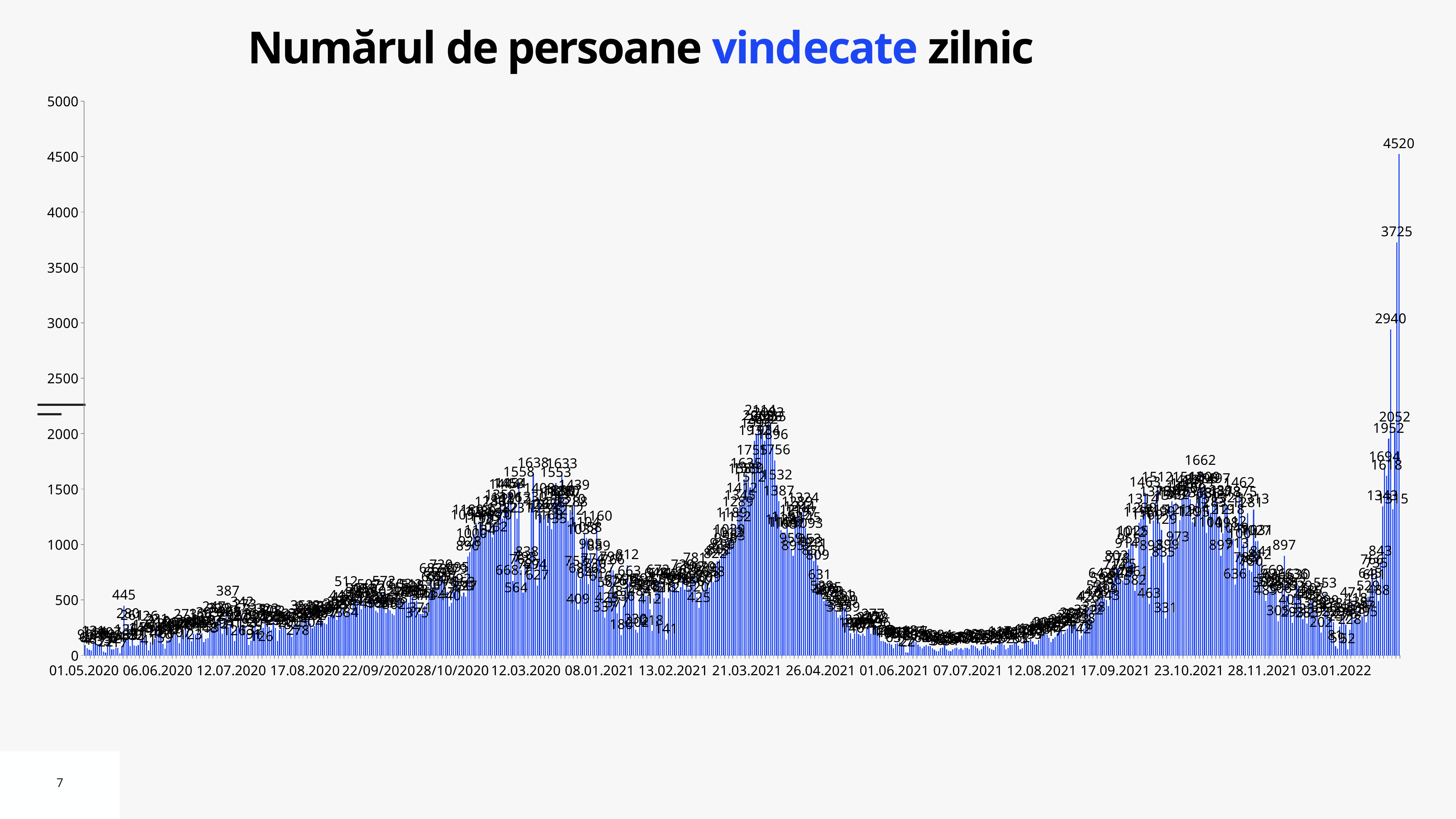
What kind of chart is shown on the slide? bar chart Is the highest bar on the chart greater or less than 4000? greater What is the title of the chart? Numărul de persoane vindecate zilnic What is the second-highest value labeled on the chart, just before the 4520 bar? 3725 What is the topmost tick value on the vertical axis? 5000 Do the values rise or fall at the far right end of the x axis, after 03.01.2022? rise What is the difference between the two highest labeled values, 4520 and 3725? 795 What is the highest labeled value near 06.06.2020? 445 Which peak is higher, the one around 21.03.2021 or the one around 23.10.2021? the one around 21.03.2021 What is the highest value labeled on the chart? 4520 What is the highest labeled value in the peak around 23.10.2021? 1662 Do the values rise or fall between 26.04.2021 and 01.06.2021? fall